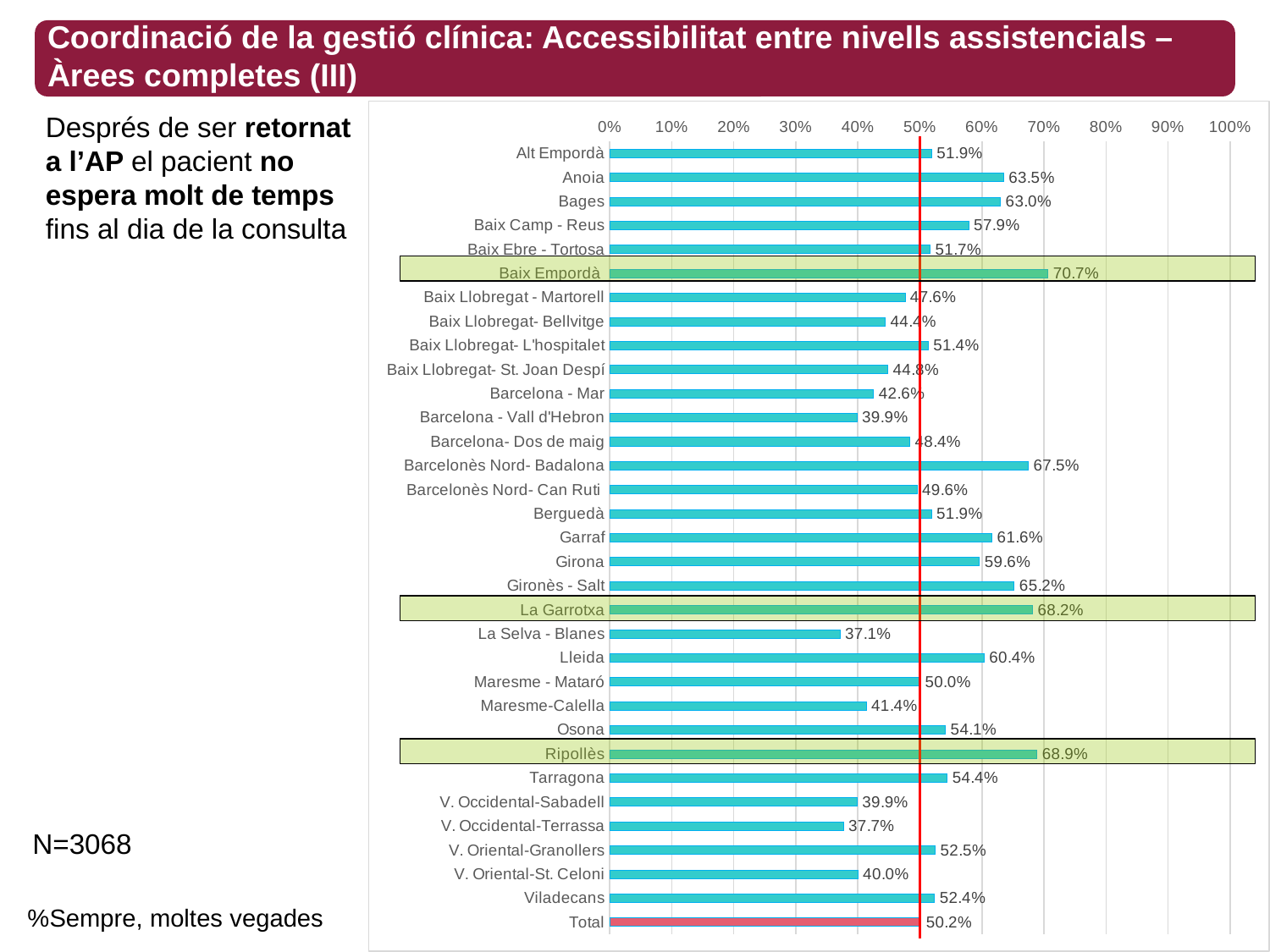
What is the value for Baix Empordà? 70.7% Which area has the lowest value? La Selva - Blanes What is the difference between Baix Empordà and Total? 20.5 percentage points How many bars are shown in the chart, including Total? 33 Is the value for Lleida greater or less than 50%? greater Which is larger, Barcelonès Nord- Badalona or Gironès - Salt? Barcelonès Nord- Badalona Which area has the highest value? Baix Empordà What is the value for La Garrotxa? 68.2% What kind of chart is shown on the slide? Bar chart What is the difference between Ripollès and La Garrotxa? 0.7 percentage points What is the value for Total? 50.2% What is the value for V. Occidental-Terrassa? 37.7%